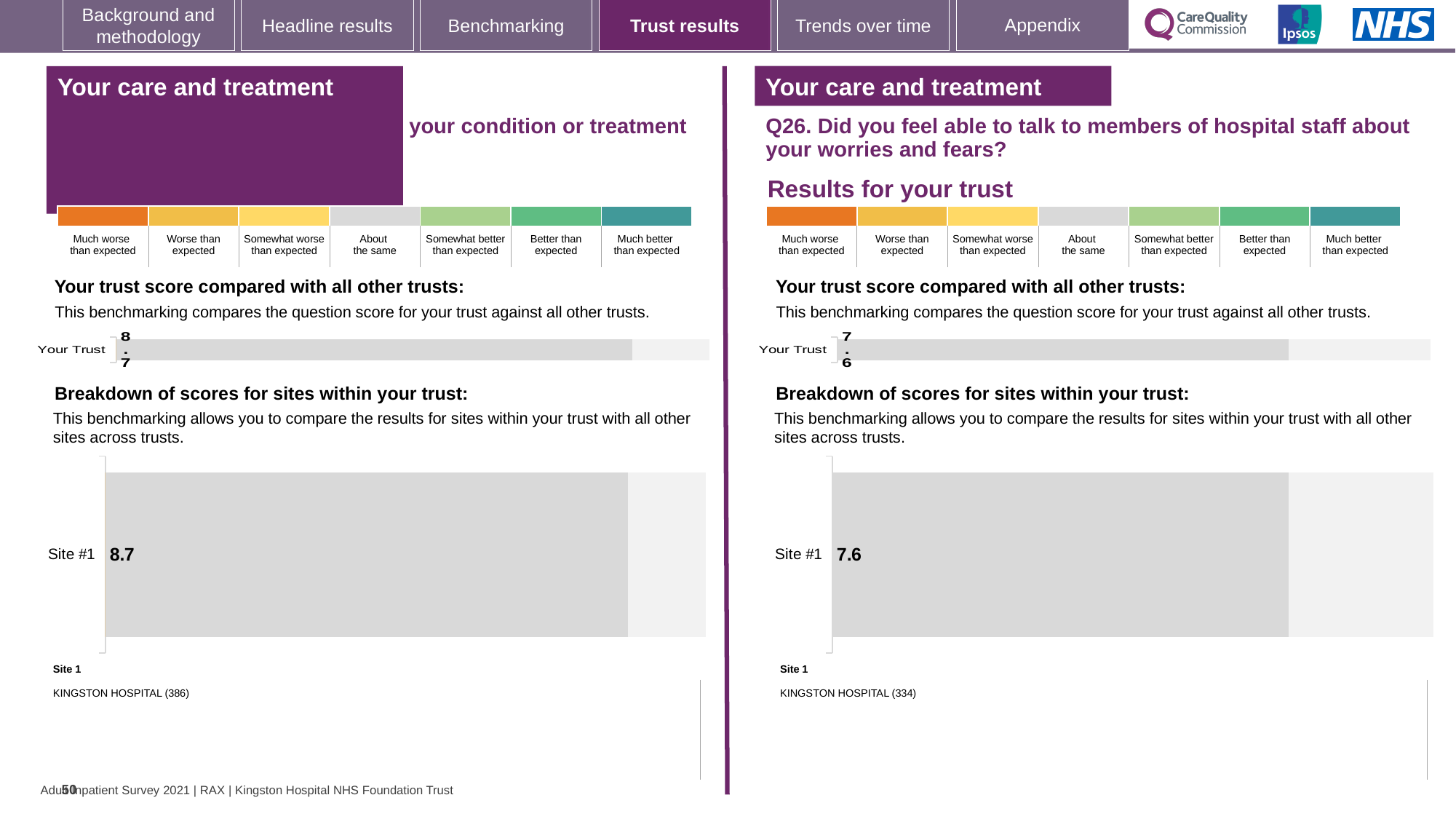
Which hospital is listed as Site 1 on the Q26 side of the slide? KINGSTON HOSPITAL Which trust score is larger: the left-hand chart's Your Trust score or the Q26 Your Trust score? The left-hand chart (8.7) In the Q26 breakdown of scores for sites within your trust, what is the score for Site #1? 7.6 What kind of chart is used to show the Your Trust score on the Q26 side? Bar chart How many sites are shown in the Q26 breakdown of scores for sites within your trust? 1 On the left-hand chart (question about your condition or treatment), what is the score shown for Your Trust? 8.7 On the right-hand chart for Q26, what is the score shown for Your Trust? 7.6 What is the difference between the left-hand Your Trust score and the Q26 Your Trust score? 1.1 What number appears in brackets after KINGSTON HOSPITAL on the Q26 side of the slide? 334 How many benchmark categories are shown in the colour key above the Q26 trust score chart? 7 In the left-hand breakdown of scores for sites within your trust, what is the score for Site #1? 8.7